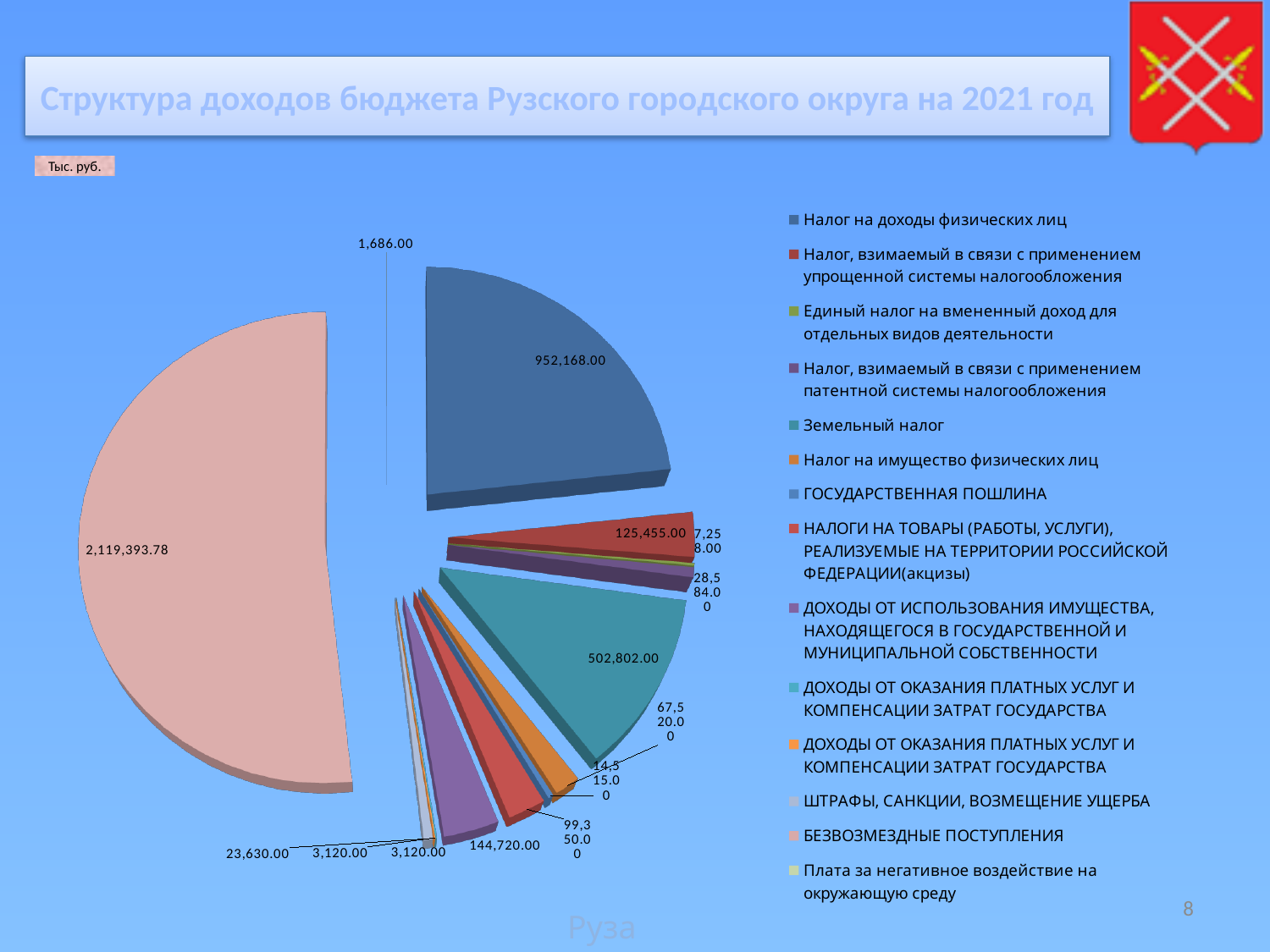
What is the value for БЕЗВОЗМЕЗДНЫЕ ПОСТУПЛЕНИЯ? 2,119,393.78 What is the difference between the values for Налог на доходы физических лиц and Земельный налог? 449,366.00 In what units are the chart values given, according to the label on the slide? Тыс. руб. What is the title of the slide containing the chart? Структура доходов бюджета Рузского городского округа на 2021 год What is the value for Налог на доходы физических лиц? 952,168.00 Which is larger: the value for Налог на доходы физических лиц or the value for Земельный налог? Налог на доходы физических лиц What is the value for Земельный налог? 502,802.00 What kind of chart is shown on the slide? pie chart Which category has the smallest value in the chart? Плата за негативное воздействие на окружающую среду Which category has the largest slice of the pie? БЕЗВОЗМЕЗДНЫЕ ПОСТУПЛЕНИЯ How many entries does the chart legend list? 14 What is the value for ШТРАФЫ, САНКЦИИ, ВОЗМЕЩЕНИЕ УЩЕРБА? 23,630.00